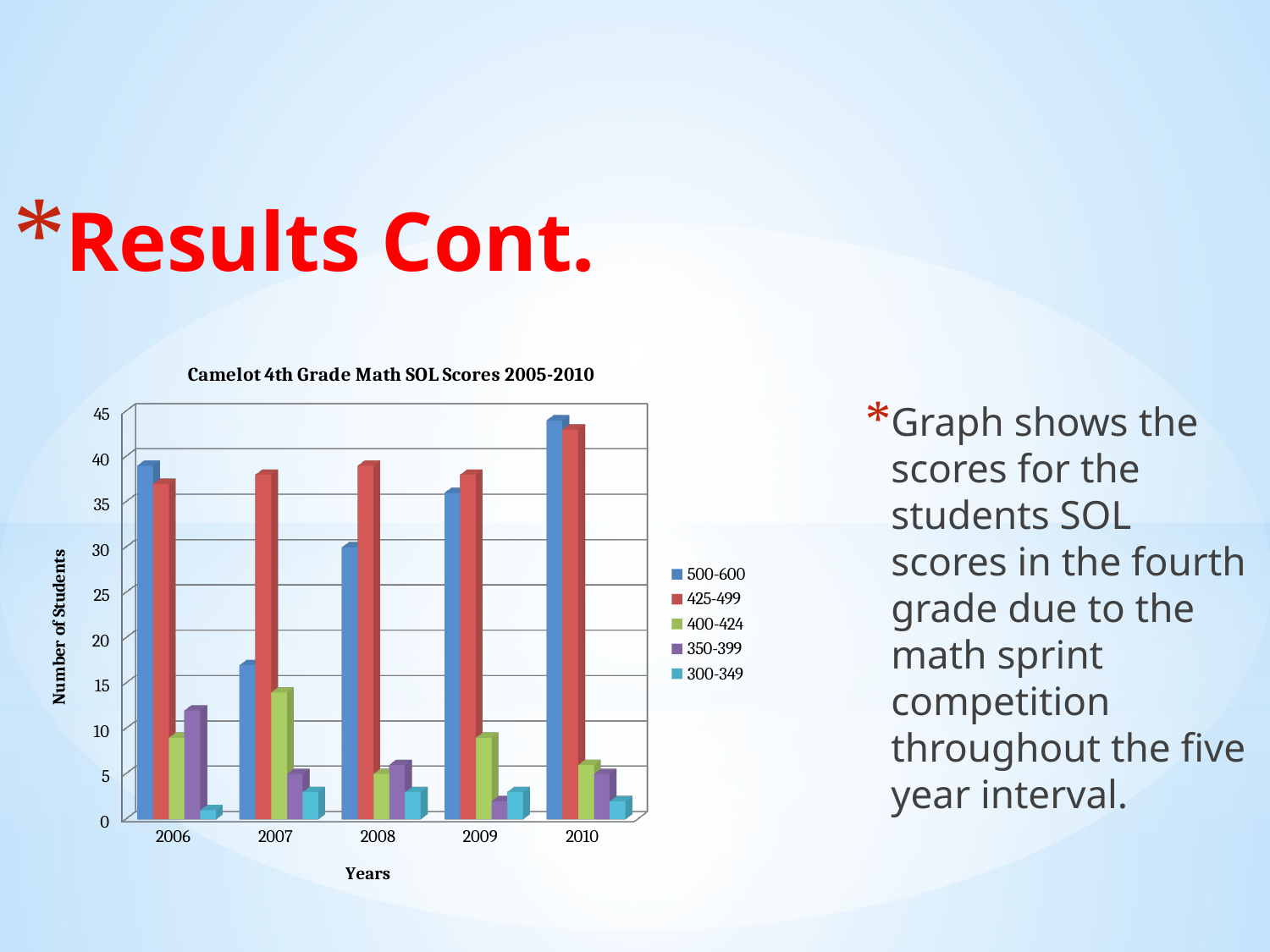
In 2007, which is larger: the 500-600 bar or the 425-499 bar? 425-499 In which year is the 500-600 bar the lowest? 2007 What is the title of the chart? Camelot 4th Grade Math SOL Scores 2005-2010 Is the value for 425-499 in 2008 greater or less than 35? greater Does the 500-600 series rise or fall from 2007 to 2010? rise Is the value for 500-600 in 2007 greater or less than 20? less In which year is the 500-600 bar the highest? 2010 How many years are shown on the x axis? 5 What kind of chart is shown on the slide? bar chart What is the label of the vertical axis? Number of Students How many series does the legend list? 5 Is the value for 300-349 in 2006 greater or less than 5? less